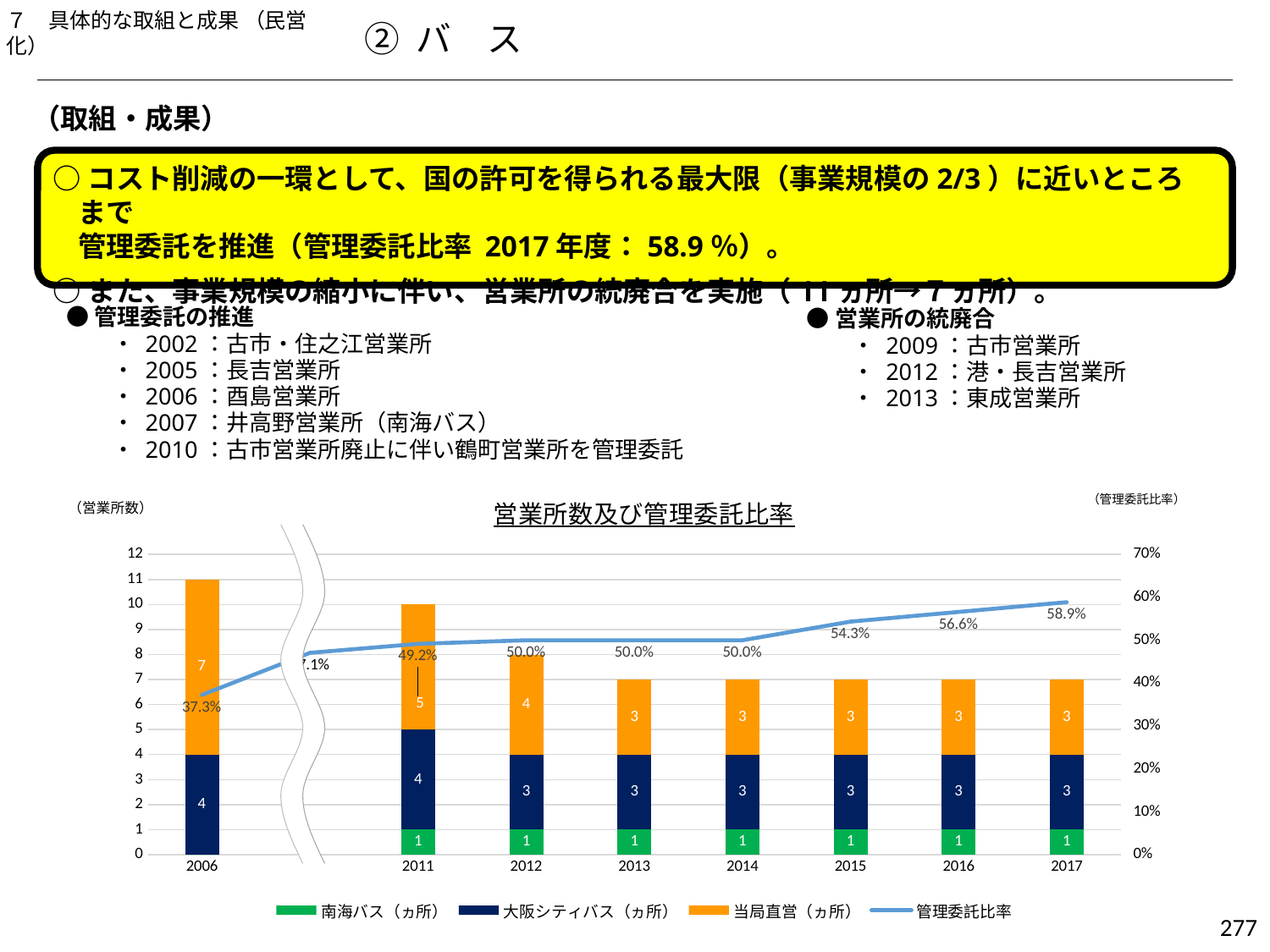
In the chart 営業所数及び管理委託比率, which year has more 当局直営 offices, 2006 or 2011? 2006 In the chart 営業所数及び管理委託比率, what is the value for 当局直営 in 2012? 4 In the chart 営業所数及び管理委託比率, what is the 管理委託比率 for 2017? 58.9% How many years are shown on the x axis of the chart 営業所数及び管理委託比率? 8 In the chart 営業所数及び管理委託比率, by how many percentage points did the 管理委託比率 increase from 2006 to 2017? 21.6 percentage points How many series does the legend of the chart 営業所数及び管理委託比率 list? 4 In the chart 営業所数及び管理委託比率, what is the value for 大阪シティバス in 2011? 4 In the chart 営業所数及び管理委託比率, what is the total number of offices in the stacked bar for 2006? 11 In the chart 営業所数及び管理委託比率, what is the total number of offices in the stacked bar for 2011? 10 In the chart 営業所数及び管理委託比率, which year has the lowest 管理委託比率? 2006 In the chart 営業所数及び管理委託比率, how many 当局直営 offices are shown for 2006? 7 In the chart 営業所数及び管理委託比率, which year has the highest 管理委託比率? 2017